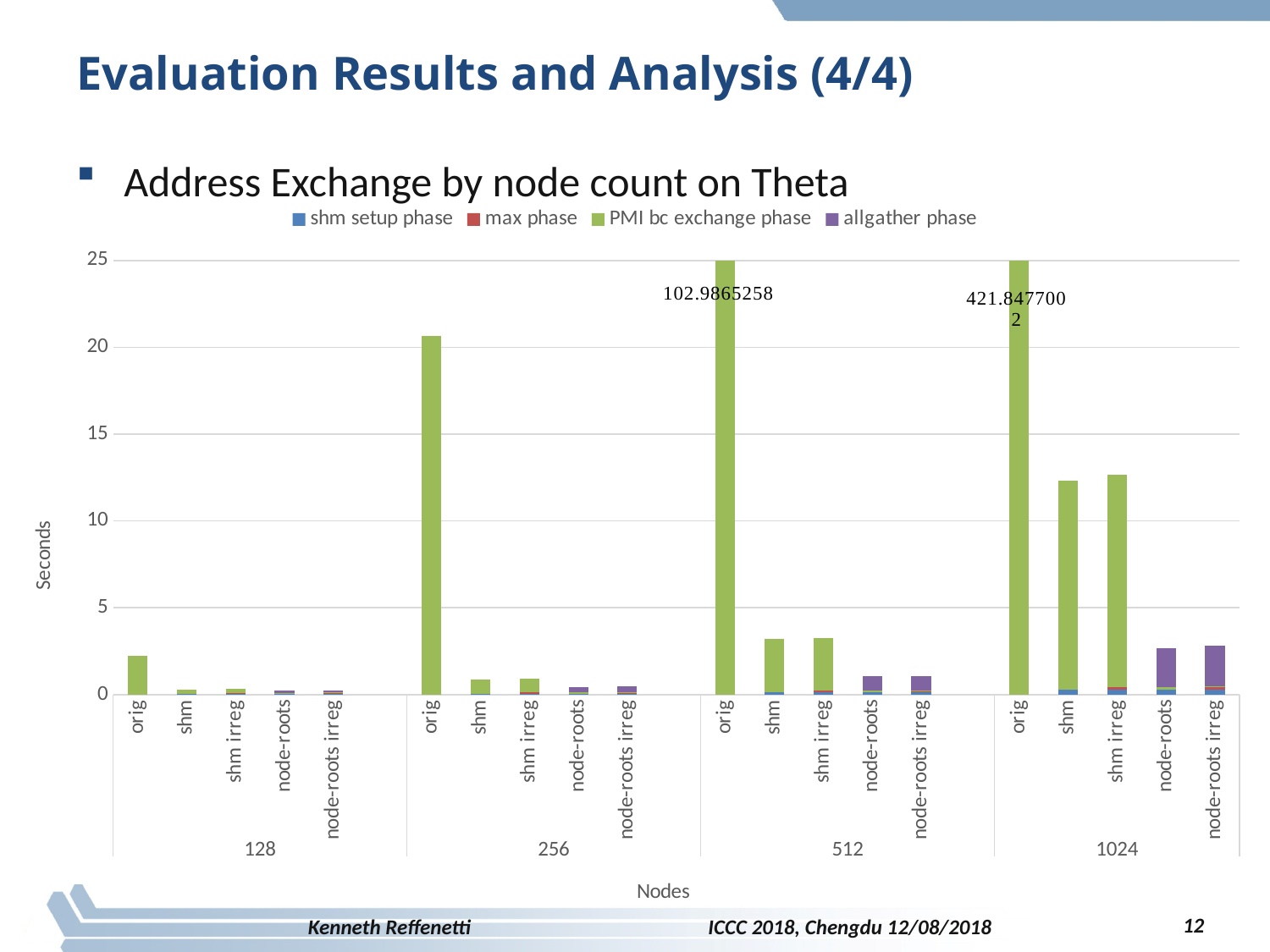
How many node counts are shown along the x axis? 4 What are the four series listed in the legend? shm setup phase, max phase, PMI bc exchange phase, allgather phase Is the total for the shm bar at 1024 nodes greater or less than 10? greater Does the height of the orig bar rise or fall as the node count increases from 128 to 1024? rise What value is printed above the orig bar for 1024 nodes? 421.8477002 Is the total for the orig bar at 128 nodes greater or less than 5? less Which node count has the tallest orig bar? 1024 What kind of chart is shown on the slide? bar chart Is the total for the orig bar at 256 nodes greater or less than 15? greater How many series does the legend list? 4 At 1024 nodes, which bar is taller: shm irreg or node-roots? shm irreg What value is printed above the orig bar for 512 nodes? 102.9865258